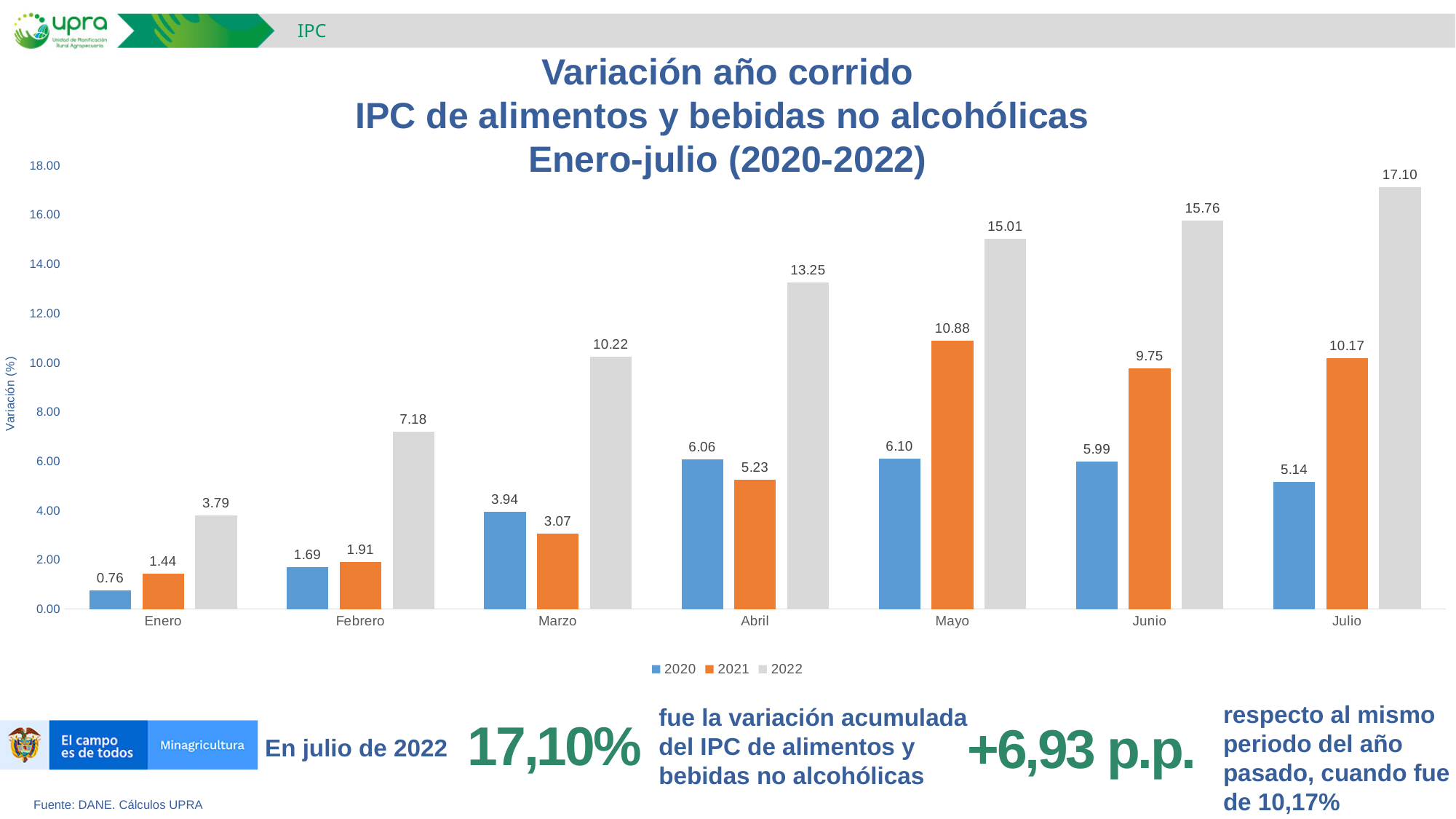
How many series does the legend list? 3 How many months are shown on the x axis? 7 Which month has the highest value for the 2022 series? Julio Which is larger in Junio: the 2020 value or the 2021 value? 2021 What is the value for 2020 in Abril? 6.06 Does the 2022 series rise or fall from Enero to Julio? Rise What is the value for 2022 in Julio? 17.10 Is the value for 2022 in Abril greater or less than 12.00? greater What is the value for 2021 in Mayo? 10.88 What is the difference between the 2022 and 2021 values in Julio? 6.93 Which month has the lowest value for the 2020 series? Enero What kind of chart is shown on the slide? Bar chart